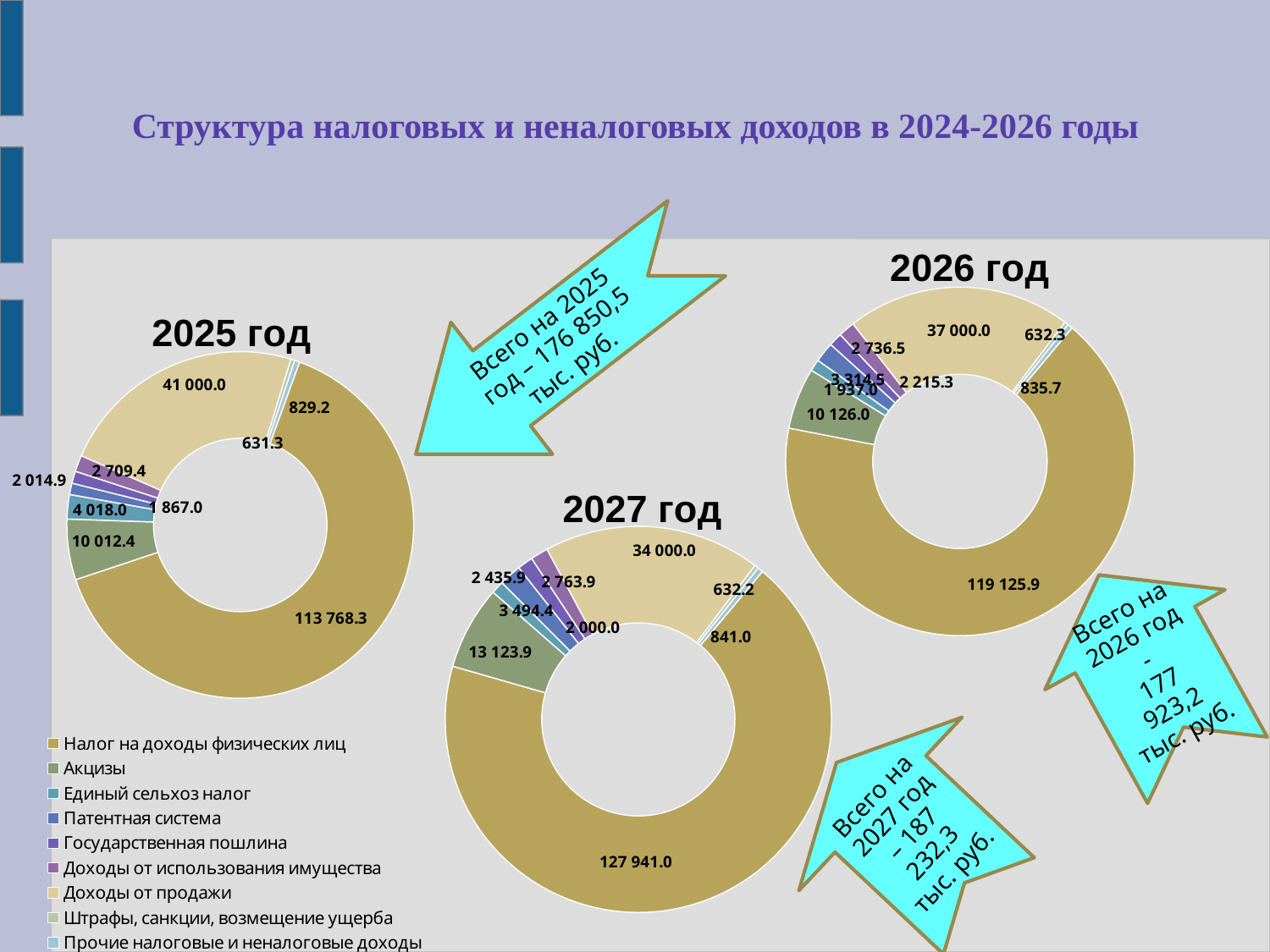
What is the difference between the Доходы от продажи values in the 2025 год chart (41 000.0) and the 2027 год chart (34 000.0)? 7 000.0 In the 2026 год chart, what is the value of the largest slice (Налог на доходы физических лиц)? 119 125.9 What kind of chart is used for each year on this slide? Doughnut (pie) chart Which year's chart has the largest value for Налог на доходы физических лиц? 2027 год In the 2025 год chart, what is the value of the Доходы от продажи slice? 41 000.0 How many categories does the legend list? 9 What is the title of the slide? Структура налоговых и неналоговых доходов в 2024-2026 годы In the 2027 год chart, what is the value of the Акцизы slice? 13 123.9 In the 2025 год chart, what is the value of the largest slice (Налог на доходы физических лиц)? 113 768.3 How many charts are shown on the slide? 3 In the 2027 год chart, what is the value of the largest slice (Налог на доходы физических лиц)? 127 941.0 In the 2026 год chart, which slice has the smallest value? Штрафы, санкции, возмещение ущерба (632.3)